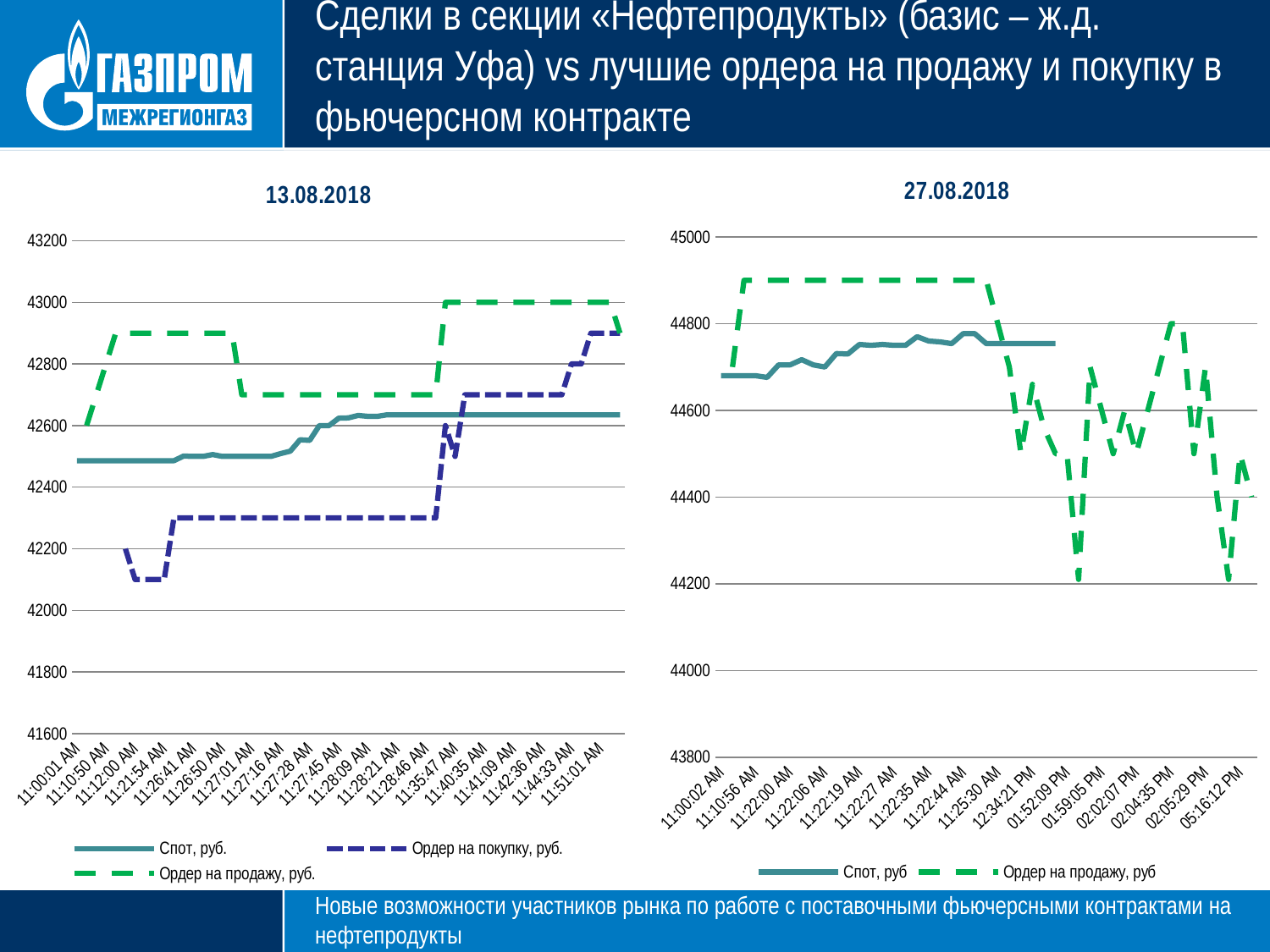
In the 27.08.2018 chart, which series is drawn with a green dashed line? Ордер на продажу, руб In the 13.08.2018 chart, is the value of Ордер на продажу, руб. at 11:12:00 AM greater or less than 42800? greater What kind of chart is the chart titled 13.08.2018? line chart How many series does the legend of the 13.08.2018 chart list? 3 How many series does the legend of the 27.08.2018 chart list? 2 In the 13.08.2018 chart, which series is shown as a solid line? Спот, руб. In the 13.08.2018 chart, at 11:26:41 AM, which is larger: Ордер на продажу, руб. or Ордер на покупку, руб.? Ордер на продажу, руб. In the 13.08.2018 chart, is the value of Спот, руб. at 11:00:01 AM greater or less than 42400? greater In the 27.08.2018 chart, is the value of Ордер на продажу, руб at 11:22:00 AM greater or less than 44800? greater In the 13.08.2018 chart, does the Спот, руб. series rise or fall from the first to the last time point? rise